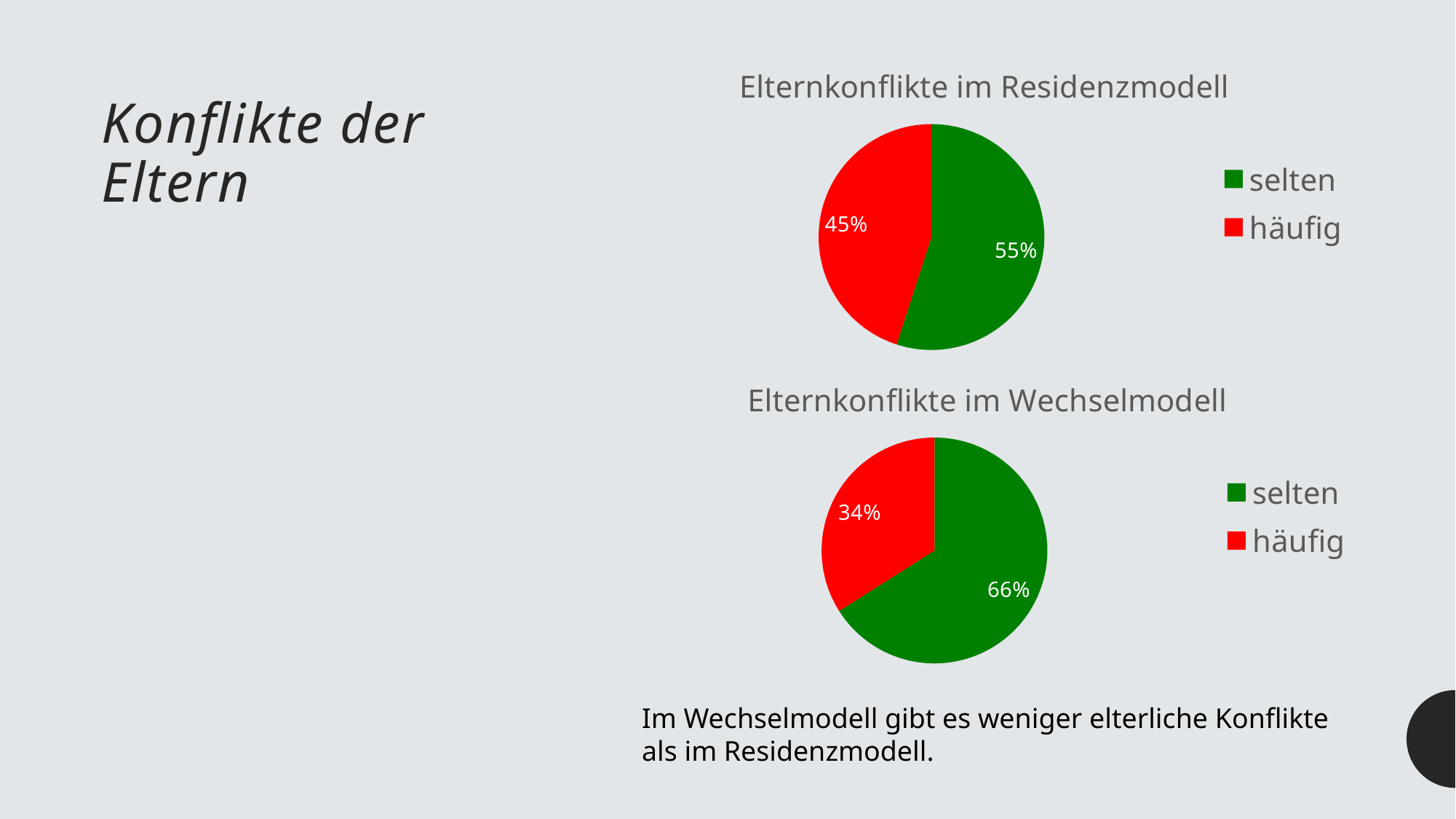
In the 'Elternkonflikte im Residenzmodell' chart, which slice is the largest? selten How many slices does the 'Elternkonflikte im Residenzmodell' pie chart have? 2 In the 'Elternkonflikte im Wechselmodell' chart, what share of the pie is 'selten'? 66% In the 'Elternkonflikte im Wechselmodell' chart, what share of the pie is 'häufig'? 34% What kind of chart is 'Elternkonflikte im Wechselmodell'? pie chart Is the 'häufig' share larger in the 'Elternkonflikte im Residenzmodell' chart or in the 'Elternkonflikte im Wechselmodell' chart? Elternkonflikte im Residenzmodell In the 'Elternkonflikte im Residenzmodell' chart, what is the difference between the 'selten' and 'häufig' shares? 10% In the 'Elternkonflikte im Residenzmodell' chart, what share of the pie is 'häufig'? 45% In the 'Elternkonflikte im Wechselmodell' chart, what is the difference between the 'selten' and 'häufig' shares? 32% In the 'Elternkonflikte im Wechselmodell' chart, which colour represents 'häufig'? red In the 'Elternkonflikte im Wechselmodell' chart, which slice is the smallest? häufig